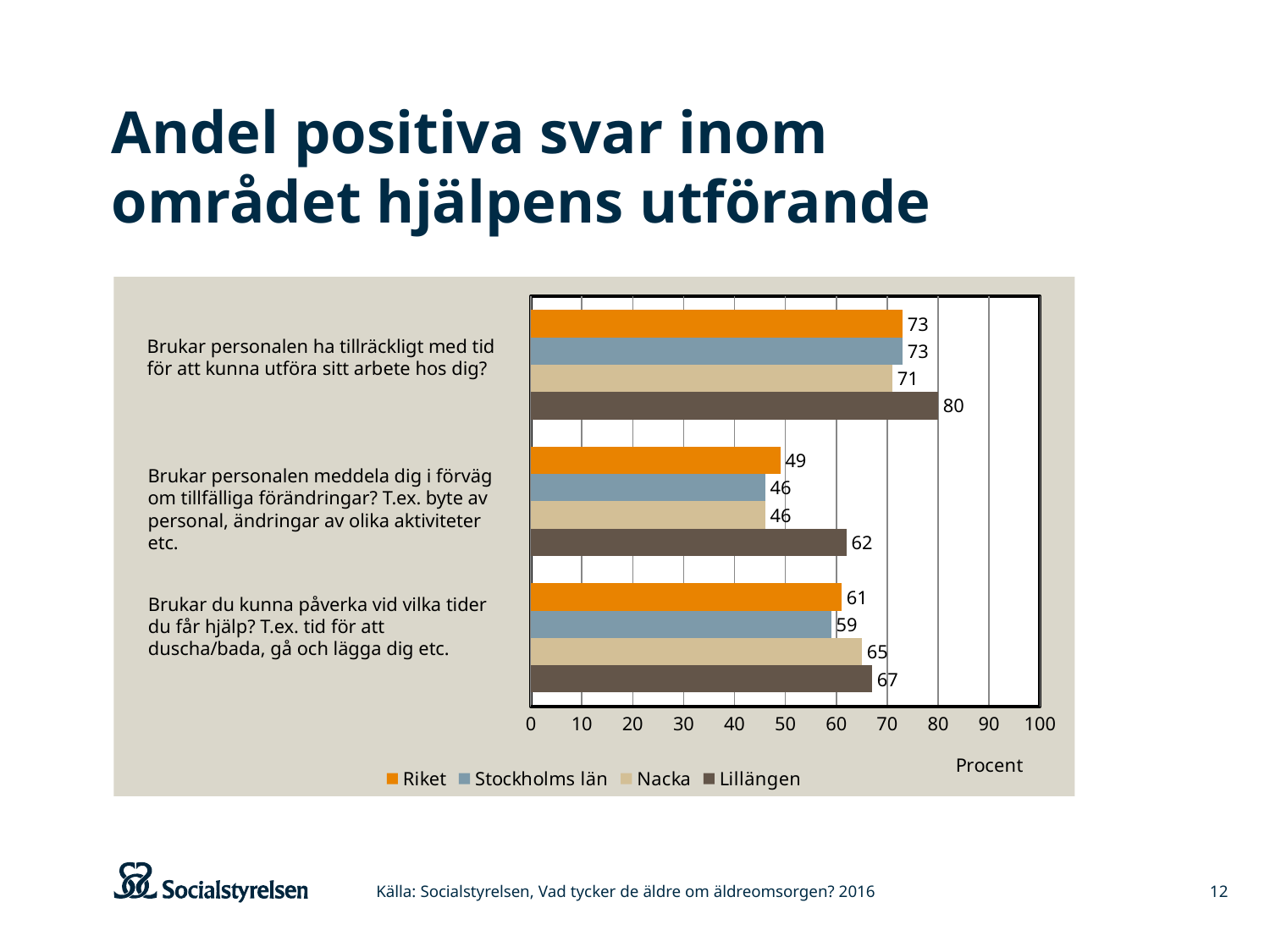
Which series has the lowest value for the question "Brukar du kunna påverka vid vilka tider du får hjälp?"? Stockholms län For the question "Brukar du kunna påverka vid vilka tider du får hjälp?", which is larger: the value for Nacka or the value for Riket? Nacka Which series has the highest value for the question "Brukar personalen meddela dig i förväg om tillfälliga förändringar?"? Lillängen What is the value for Lillängen for the question "Brukar personalen ha tillräckligt med tid för att kunna utföra sitt arbete hos dig?"? 80 What kind of chart is shown on the slide? Bar chart What is the label of the x axis? Procent How many questions (categories) are shown on the chart? 3 What is the value for Stockholms län for the question "Brukar personalen ha tillräckligt med tid för att kunna utföra sitt arbete hos dig?"? 73 What is the value for Riket for the question "Brukar personalen meddela dig i förväg om tillfälliga förändringar?"? 49 How many series does the legend list? 4 What is the difference between the Lillängen and Riket values for the question "Brukar personalen meddela dig i förväg om tillfälliga förändringar?"? 13 What is the value for Nacka for the question "Brukar du kunna påverka vid vilka tider du får hjälp?"? 65